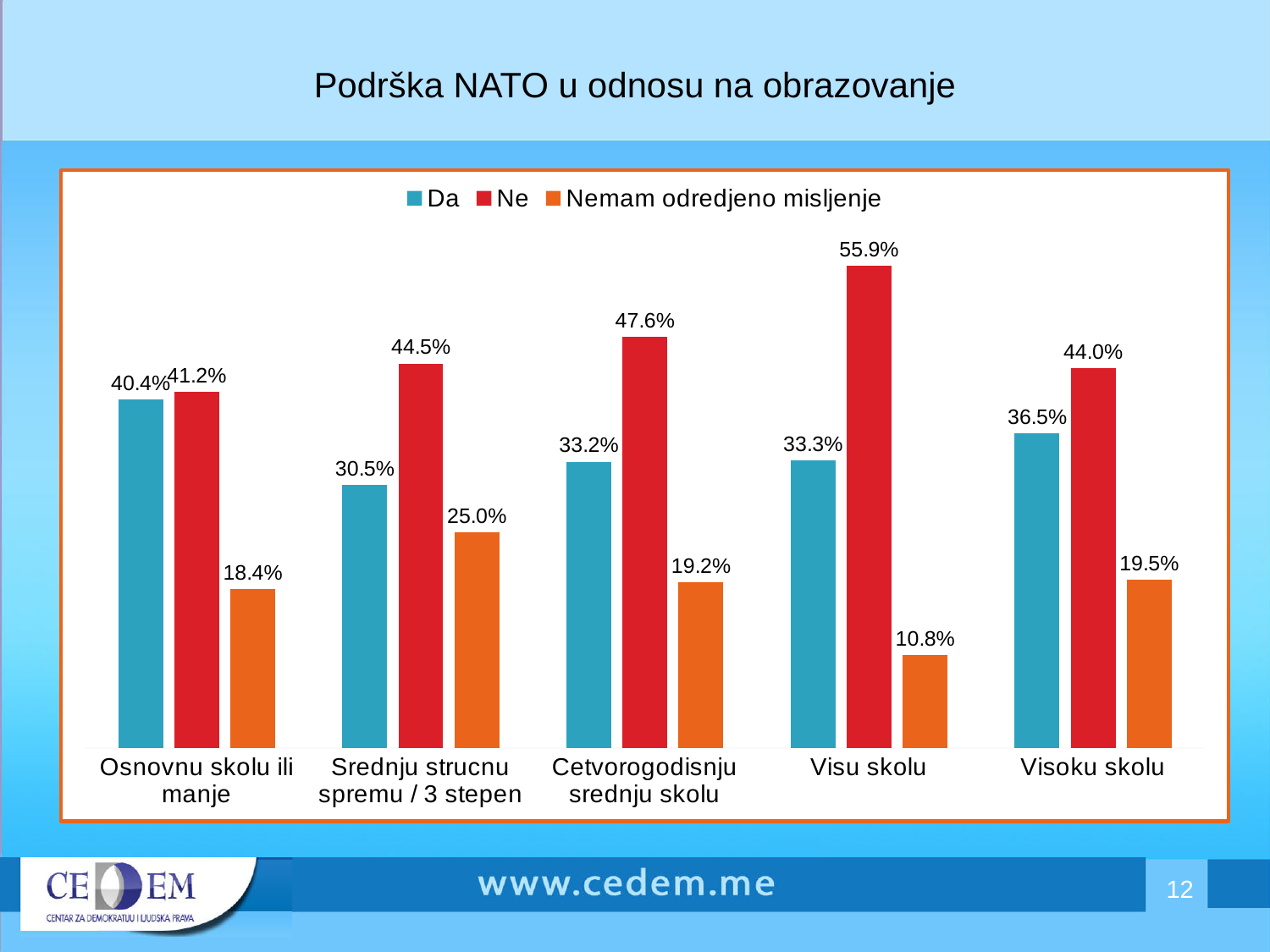
How many education categories are shown on the x axis? 5 What is the value of the "Da" series for "Visu skolu"? 33.3% What kind of chart is shown on the slide? Bar chart What colour are the bars for the "Nemam odredjeno misljenje" series? Orange Which category has the highest value for the "Ne" series? Visu skolu Which category has the lowest value for the "Nemam odredjeno misljenje" series? Visu skolu What is the title of the slide? Podrška NATO u odnosu na obrazovanje What is the difference between the "Ne" and "Da" values for "Visu skolu"? 22.6% Which is larger for "Cetvorogodisnju srednju skolu": the "Da" value or the "Ne" value? Ne What is the value of the "Nemam odredjeno misljenje" series for "Visoku skolu"? 19.5% How many series does the legend list? 3 What is the value of the "Ne" series for "Srednju strucnu spremu / 3 stepen"? 44.5%